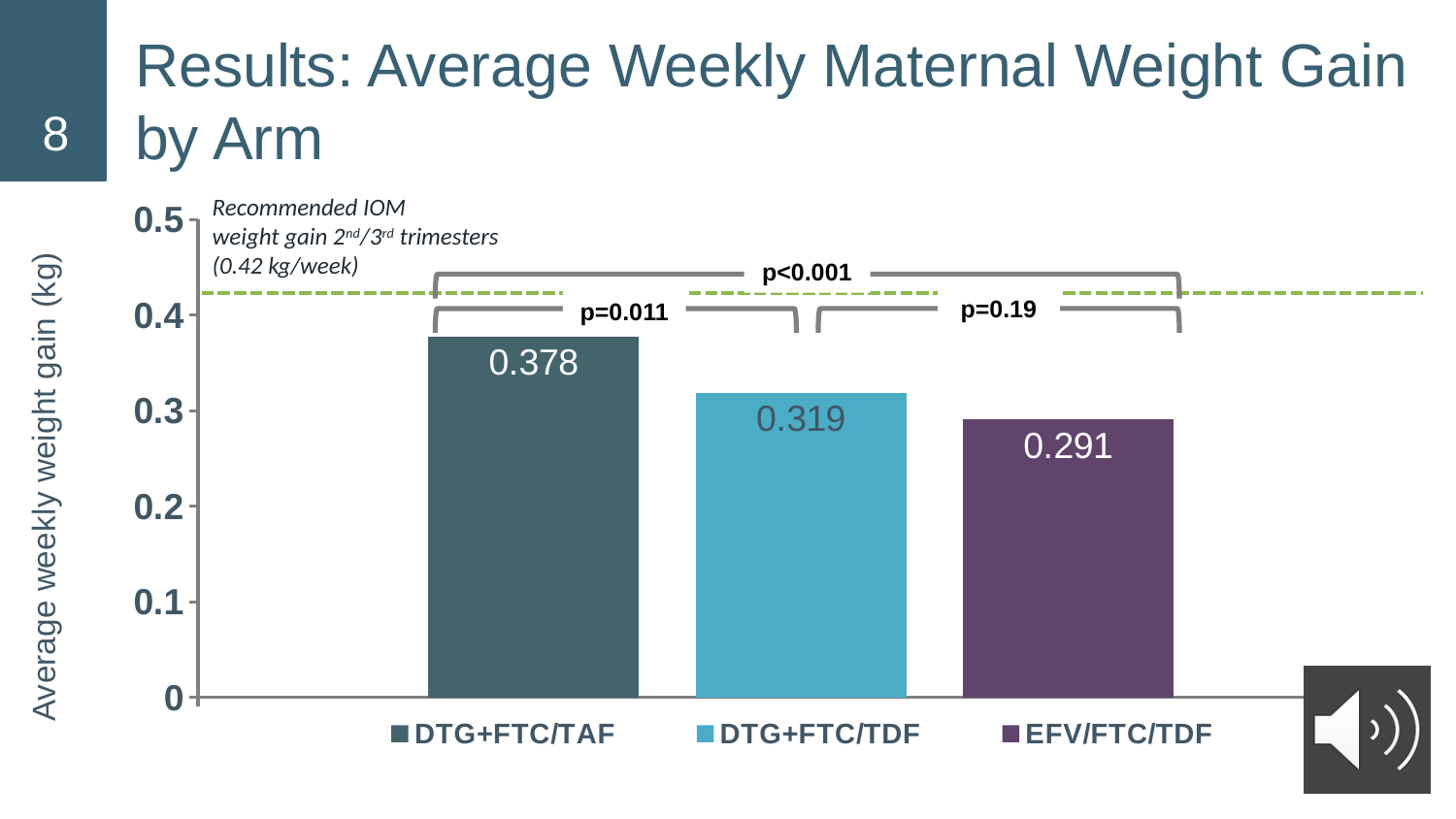
What is the difference in average weekly weight gain between DTG+FTC/TAF and EFV/FTC/TDF? 0.087 Which arm has the highest average weekly weight gain? DTG+FTC/TAF What is the average weekly weight gain for the DTG+FTC/TAF arm? 0.378 Which arm has a larger average weekly weight gain, DTG+FTC/TDF or EFV/FTC/TDF? DTG+FTC/TDF Which arm has the lowest average weekly weight gain? EFV/FTC/TDF What is the average weekly weight gain for the EFV/FTC/TDF arm? 0.291 What is the p-value shown for the comparison between DTG+FTC/TAF and DTG+FTC/TDF? p=0.011 Is the value for DTG+FTC/TAF greater or less than 0.4? less How many arms are shown in the chart? 3 What is the average weekly weight gain for the DTG+FTC/TDF arm? 0.319 What kind of chart is shown on the slide? bar chart What is the difference in average weekly weight gain between DTG+FTC/TAF and DTG+FTC/TDF? 0.059